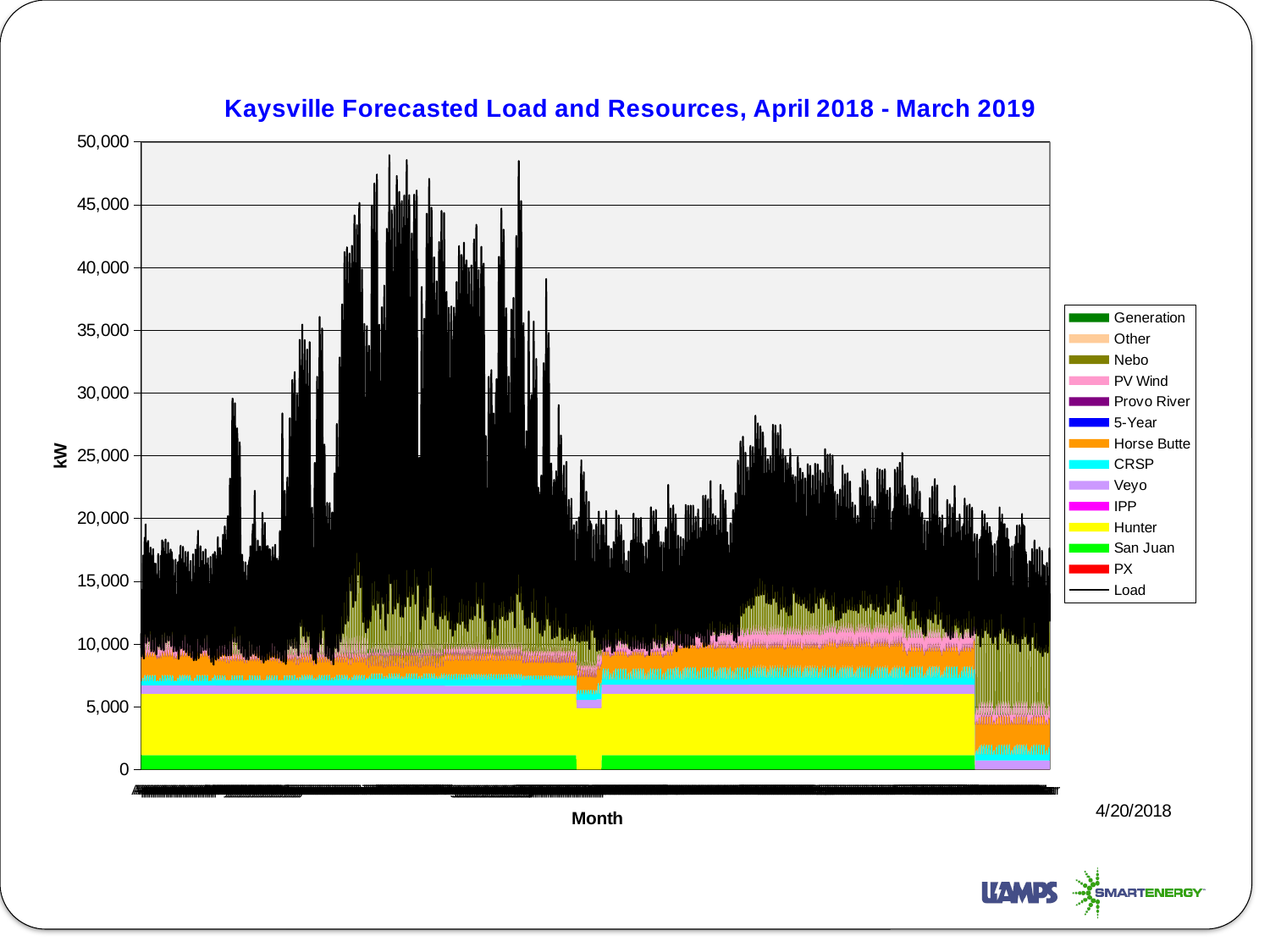
Is the Hunter resource band greater or less than 10,000 kW in height? less Which series is drawn as a black line rather than a filled area? Load Which resource series forms the largest band in the stacked area? Hunter How many series does the chart's legend list? 14 Which series is plotted at the bottom of the stack? San Juan What kind of chart is shown on the slide? Stacked area chart with a line for Load What is the label of the horizontal axis? Month What is the title of the chart? Kaysville Forecasted Load and Resources, April 2018 - March 2019 Is the peak of the Load line greater or less than 45,000 kW? greater Is the lowest point of the Load line greater or less than 20,000 kW? less What is the highest value shown on the vertical axis? 50,000 What is the label of the vertical axis? kW